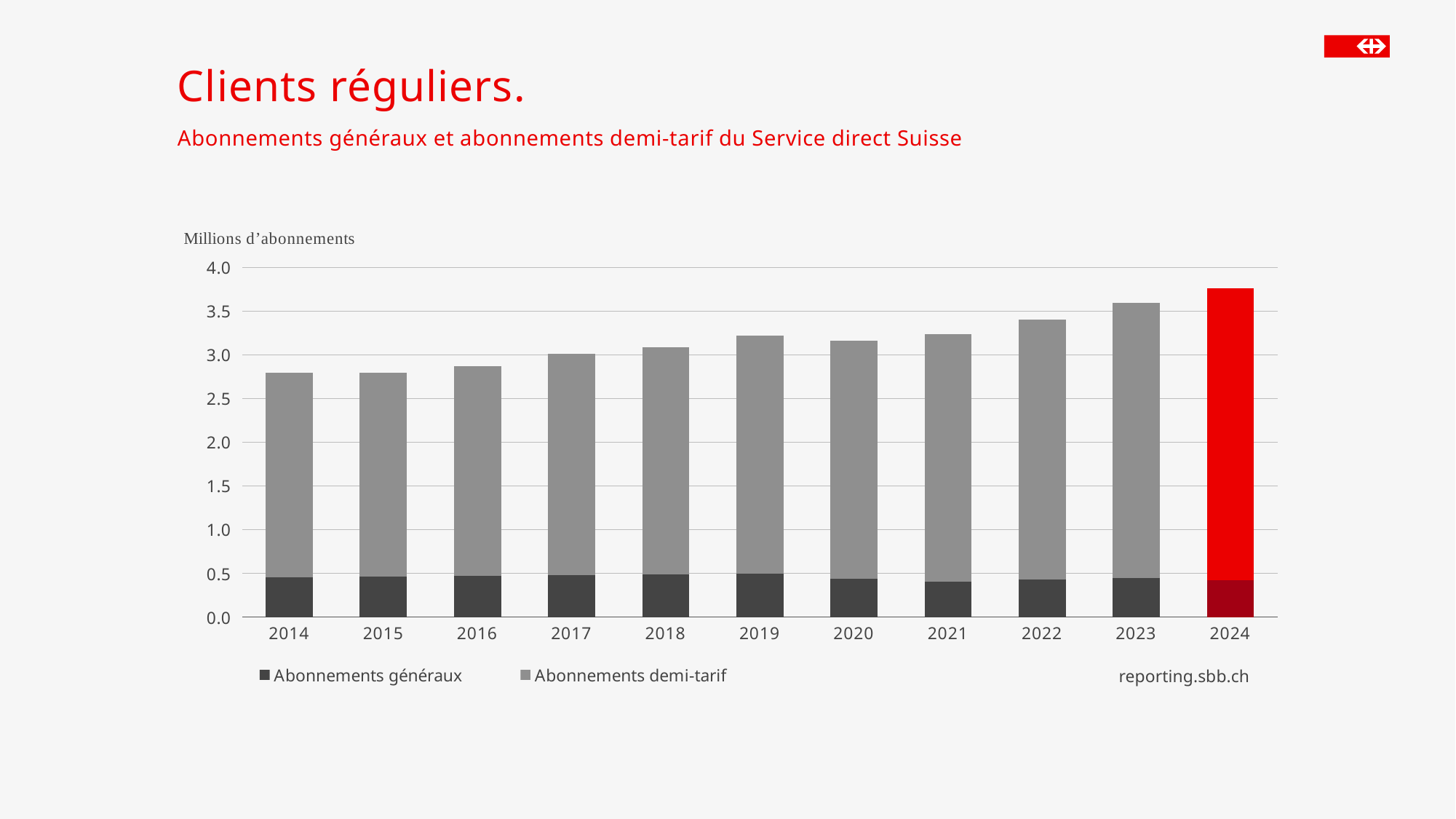
Which year's bar is highlighted in red? 2024 Which year has the larger total, 2020 or 2022? 2022 What kind of chart is shown on the slide? Stacked bar chart How many series does the legend list? 2 What is the unit label shown above the y axis? Millions d’abonnements Which year has the highest total number of subscriptions? 2024 Is the total value for 2019 greater or less than 3.0? greater Is the value for Abonnements généraux in 2021 greater or less than 0.5? less How many years are shown on the x axis of the chart? 11 Do the total subscriptions generally rise or fall from 2014 to 2024? rise Is the total value for 2024 greater or less than 3.5? greater